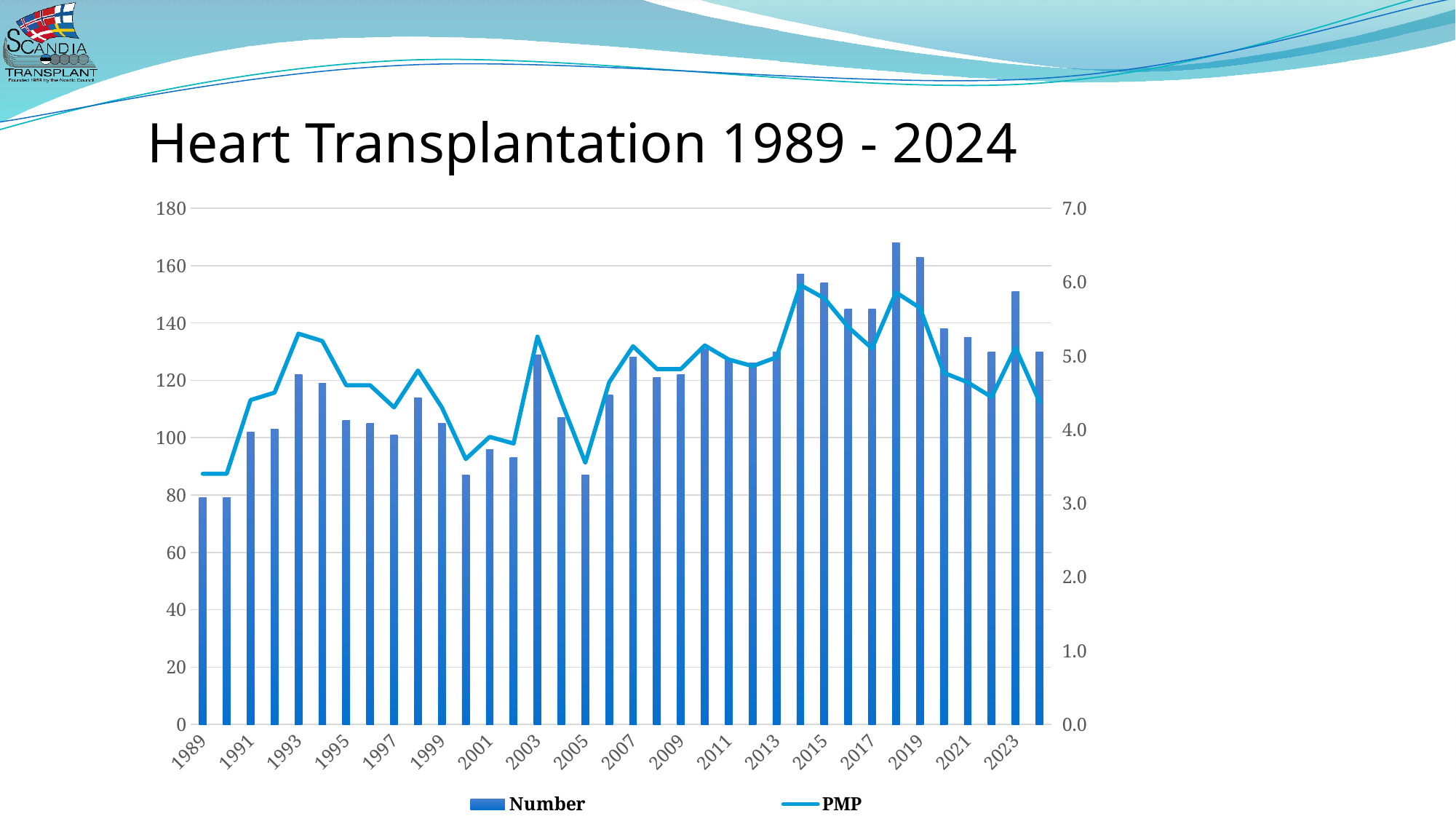
Overall, does the Number series rise or fall from 1989 to 2024? rise Is the Number value for 2014 greater or less than 140? greater Is the Number value for 2018 greater or less than 160? greater How many series does the legend list? 2 How many years are plotted along the x axis? 36 What is the title of the chart? Heart Transplantation 1989 - 2024 In which year is the Number bar highest? 2018 Which year has the larger Number value, 1993 or 1995? 1993 What kind of chart is shown on the slide? A combined bar and line chart Is the PMP value for 2014 greater or less than 5.0? greater What are the two series named in the legend? Number and PMP